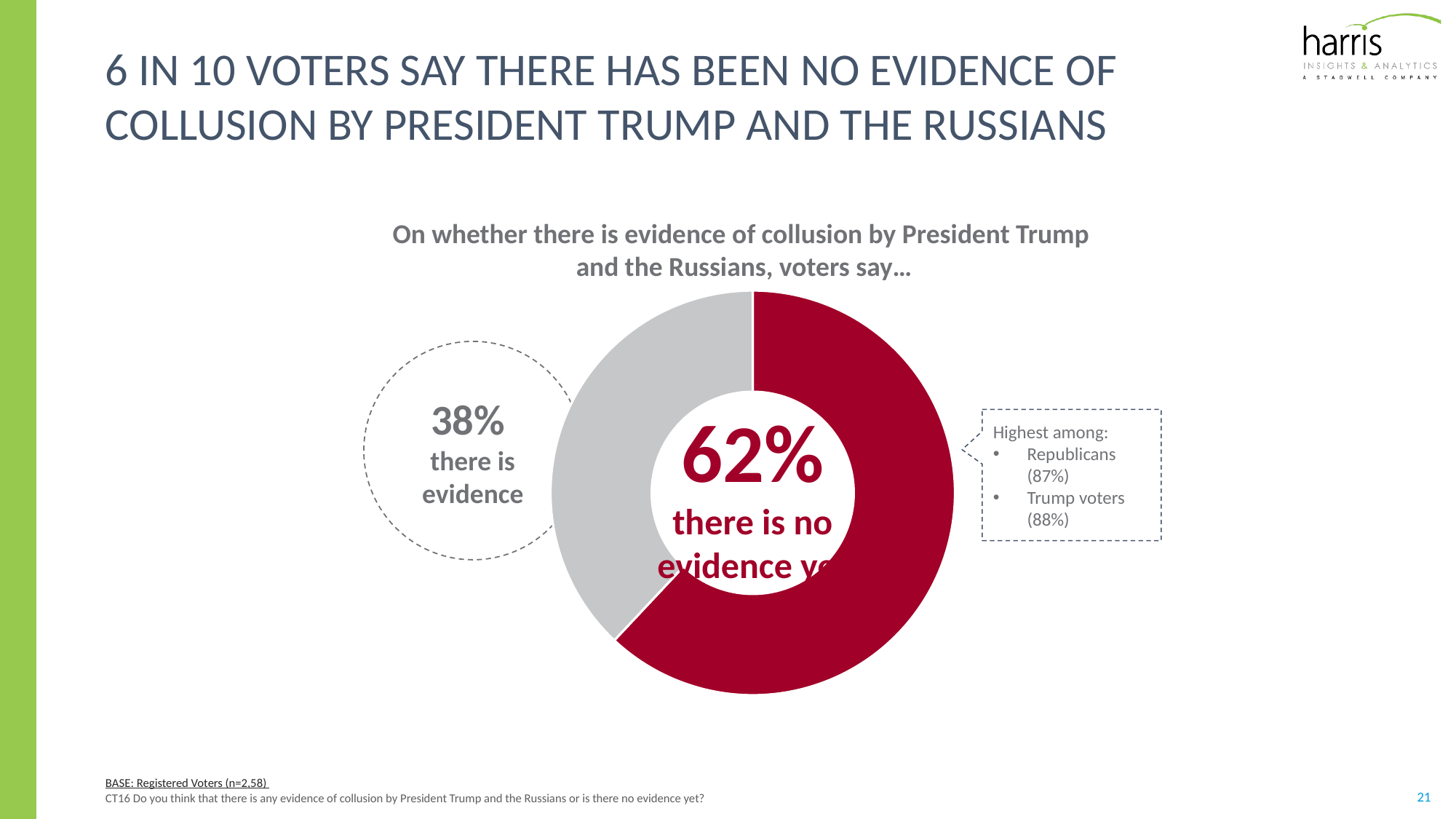
Which response has the larger share of the pie: 'there is evidence' or 'there is no evidence yet'? there is no evidence yet According to the callout, what percentage of Republicans say there is no evidence yet? 87% What colour is the slice representing 'there is no evidence yet'? red What is the difference in percentage points between the 'no evidence yet' share and the 'there is evidence' share? 24 percentage points What percentage of voters say there is evidence of collusion? 38% Which response has the smaller share of the pie? there is evidence What percentage of voters say there is no evidence yet of collusion? 62% What kind of chart is shown on the slide? pie chart (donut) How many slices does the pie chart have? 2 What do the two slices of the pie add up to? 100% Is the share for 'there is evidence' larger or smaller than the share for 'there is no evidence yet'? smaller According to the callout, what percentage of Trump voters say there is no evidence yet? 88%